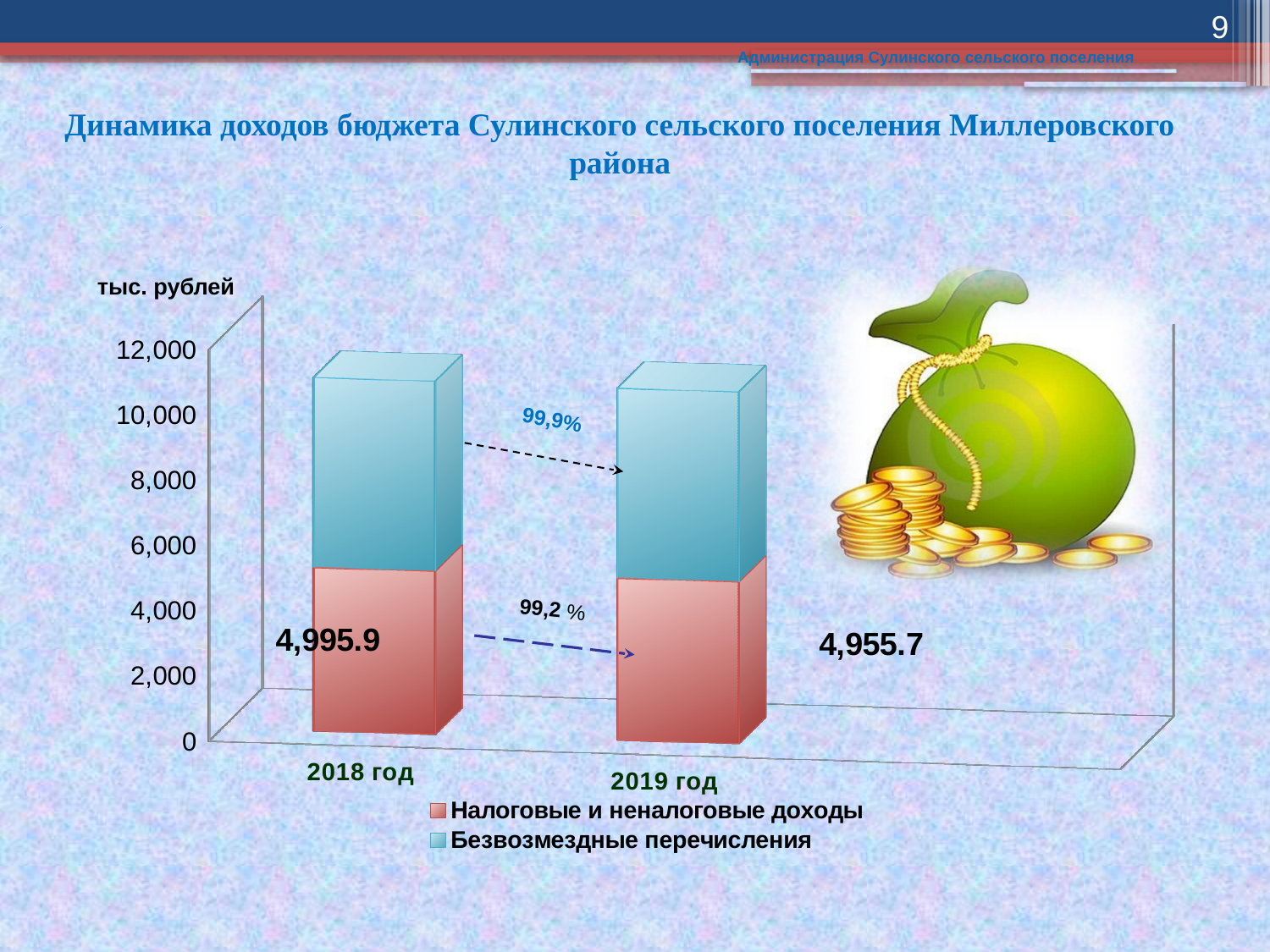
What is the difference between the Налоговые и неналоговые доходы values for 2018 год and 2019 год? 40.2 What is the value of Налоговые и неналоговые доходы for 2018 год? 4,995.9 How many years (categories) are plotted on the x axis of the chart? 2 What is the value of Налоговые и неналоговые доходы for 2019 год? 4,955.7 What kind of chart is shown on the slide? Stacked bar chart Is the total height of the stacked bar for 2018 год greater or less than 10,000? greater Which year has the larger value of Налоговые и неналоговые доходы, 2018 год or 2019 год? 2018 год How many series does the chart legend list? 2 What percentage is printed on the arrow between the Налоговые и неналоговые доходы segments of the two bars? 99,2 % Which series is shown in red in the chart legend? Налоговые и неналоговые доходы Do the Налоговые и неналоговые доходы values rise or fall from 2018 год to 2019 год? fall What unit label is printed above the vertical axis of the chart? тыс. рублей